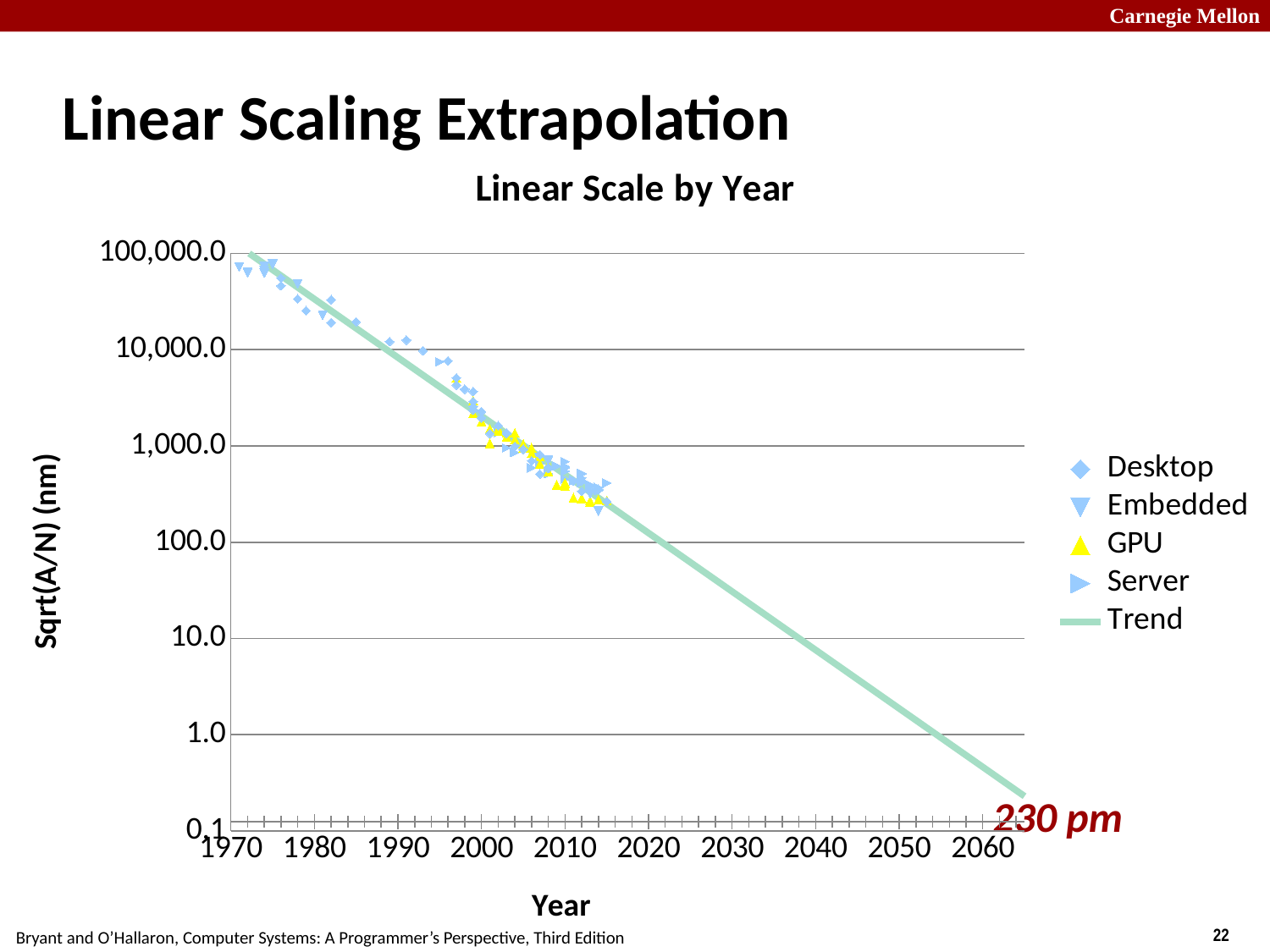
How many year labels are shown along the x axis? 10 Is the value of the Trend line at 2040 greater or less than 100.0? less What is the title of the chart? Linear Scale by Year Are the GPU values plotted around 2012 greater or less than 1,000.0? less Is the value of the Trend line at 2020 greater or less than 1,000.0? less What is the label of the y axis? Sqrt(A/N) (nm) How many series does the chart legend list? 5 What kind of chart is shown on the slide? scatter chart Which series is plotted with yellow triangle markers? GPU Do the plotted values rise or fall as the year increases along the x axis? fall